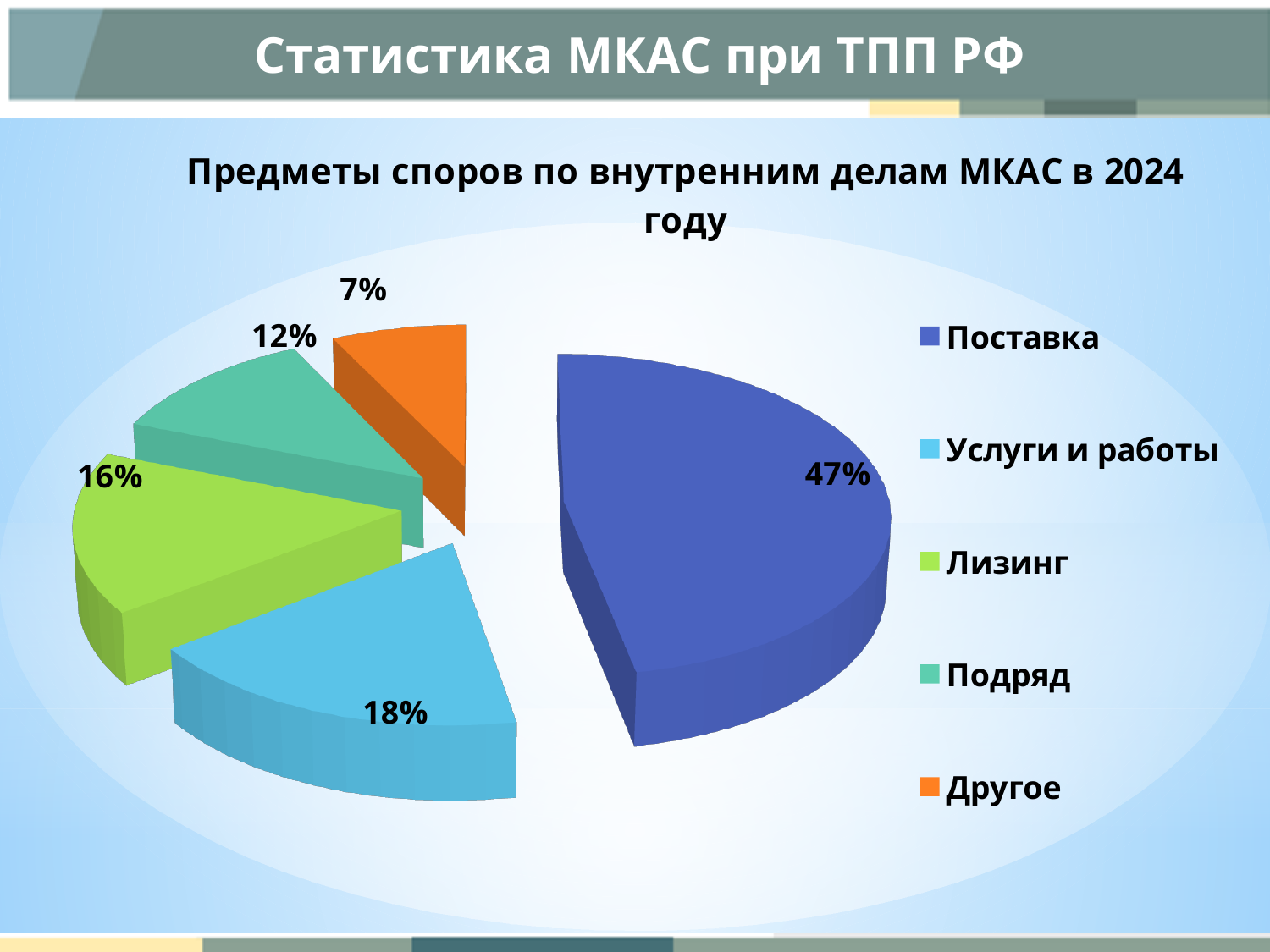
What share of the pie does Услуги и работы have? 18% Which category has the smallest slice of the pie? Другое What is the title of the chart? Предметы споров по внутренним делам МКАС в 2024 году What share of the pie does Поставка have? 47% What share of the pie does Подряд have? 12% Which category has the largest slice of the pie? Поставка What is the difference in percentage points between Поставка and Услуги и работы? 29 What kind of chart is shown on the slide? Pie chart What share of the pie does Лизинг have? 16% Which is larger, the share for Лизинг or the share for Подряд? Лизинг How many categories does the pie chart show? 5 What share of the pie does Другое have? 7%